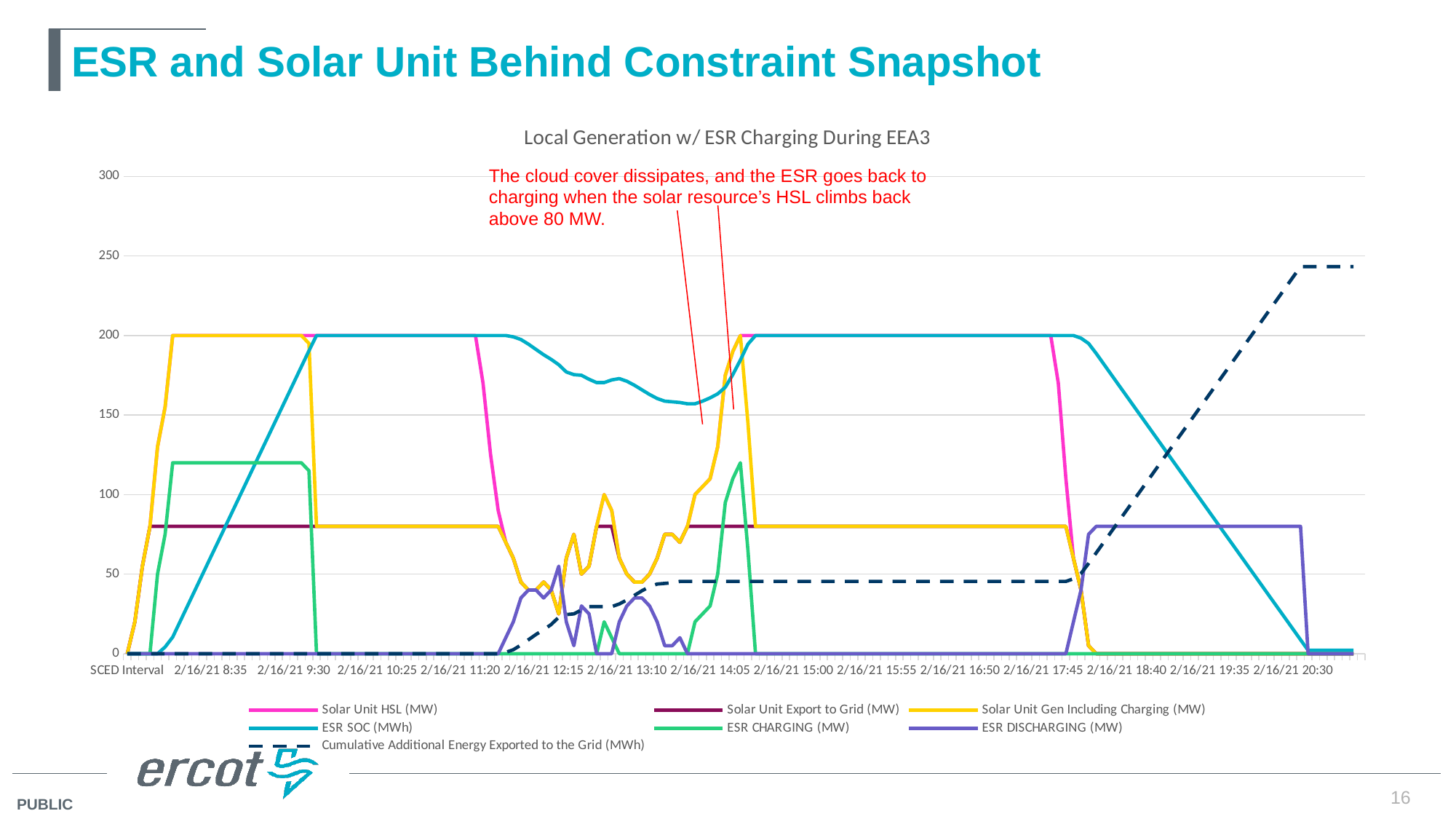
Is the value for ESR SOC (MWh) at 2/16/21 15:00 greater or less than 150? greater Which series is drawn as a dashed line in the chart? Cumulative Additional Energy Exported to the Grid (MWh) Does the ESR SOC (MWh) series rise or fall between 2/16/21 18:40 and 2/16/21 20:30? Fall Which series reaches the highest value anywhere on the chart? Cumulative Additional Energy Exported to the Grid (MWh) Is the value for Cumulative Additional Energy Exported to the Grid (MWh) at 2/16/21 20:30 greater or less than 200? greater Is the value for Solar Unit Export to Grid (MW) at 2/16/21 10:25 greater or less than 100? less What is the title of the chart? Local Generation w/ ESR Charging During EEA3 How many series does the chart's legend list? 7 What kind of chart is shown on the slide? Line chart Does the Cumulative Additional Energy Exported to the Grid (MWh) series rise or fall overall from left to right? Rise